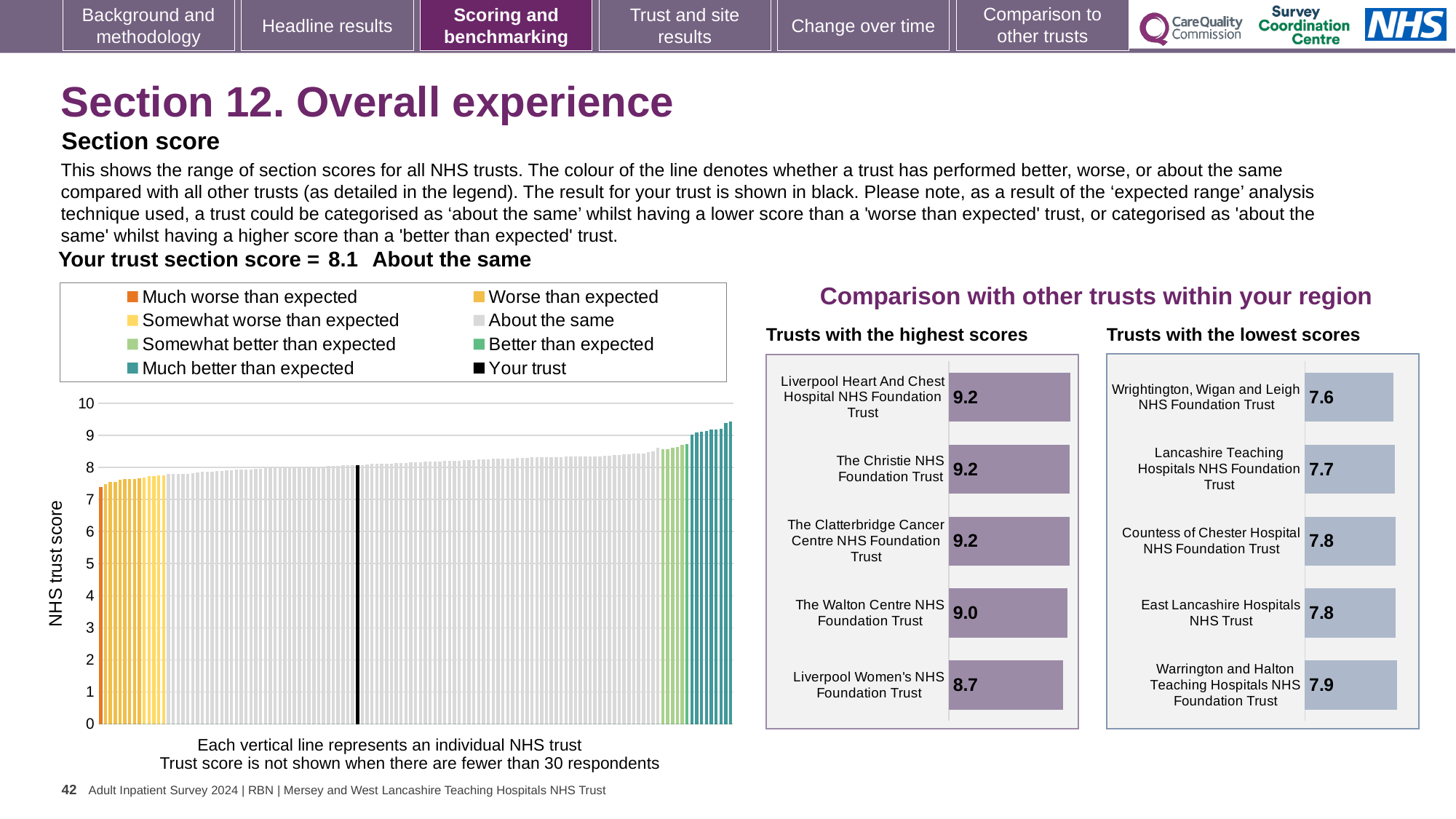
In the 'Trusts with the lowest scores' chart, how many trusts are shown? 5 In the large chart on the left, is the value of the shortest bar greater or less than 8? less In the large chart on the left, is the value of the tallest bar greater or less than 9? greater In the 'Trusts with the lowest scores' chart, which has the larger score: Lancashire Teaching Hospitals NHS Foundation Trust or Countess of Chester Hospital NHS Foundation Trust? Countess of Chester Hospital NHS Foundation Trust In the 'Trusts with the lowest scores' chart, which trust has the highest score? Warrington and Halton Teaching Hospitals NHS Foundation Trust In the large chart on the left, what is the label on the vertical axis? NHS trust score In the large chart on the left, how many entries does the legend list? 8 In the 'Trusts with the highest scores' chart, which trust has the lowest score? Liverpool Women's NHS Foundation Trust In the 'Trusts with the highest scores' chart, what is the score for The Walton Centre NHS Foundation Trust? 9.0 In the 'Trusts with the highest scores' chart, what is the difference between the score for The Christie NHS Foundation Trust and Liverpool Women's NHS Foundation Trust? 0.5 In the large chart on the left, do the bar heights rise or fall from left to right along the x axis? rise What kind of chart is the large chart on the left showing NHS trust scores? bar chart